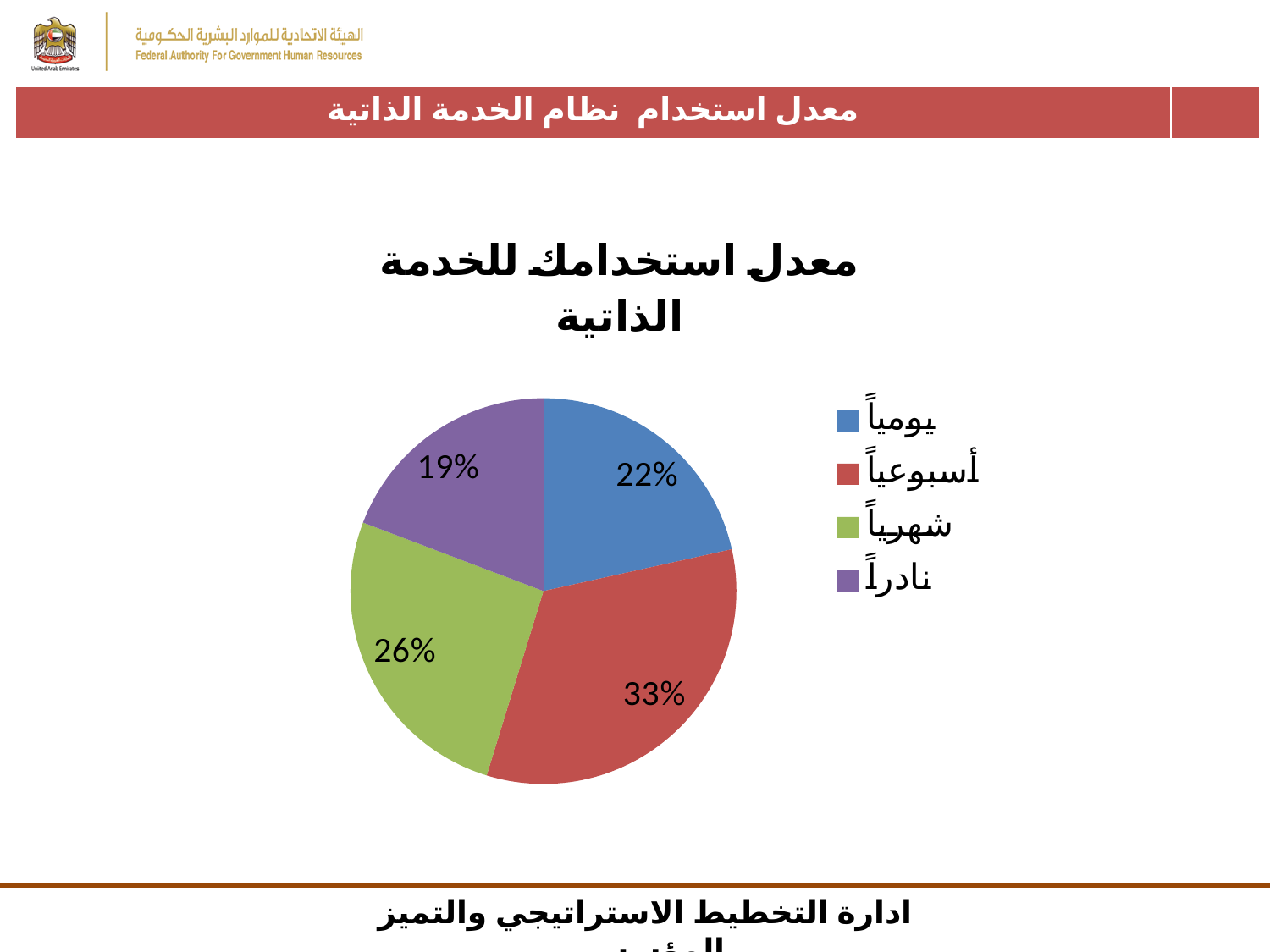
Which category has the largest share of the pie chart? أسبوعياً What colour is the slice for أسبوعياً? Red What is the value for شهرياً (monthly) in the pie chart? 26% Which category has the smallest share of the pie chart? نادراً How many entries does the legend list? 4 Which is larger, the share for شهرياً or the share for يومياً? شهرياً What is the value for نادراً (rarely) in the pie chart? 19% What is the difference between the shares for أسبوعياً and نادراً? 14% What is the value for يومياً (daily) in the pie chart? 22% What type of chart is shown on the slide? Pie chart What is the value for أسبوعياً (weekly) in the pie chart? 33% How many slices does the pie chart have? 4